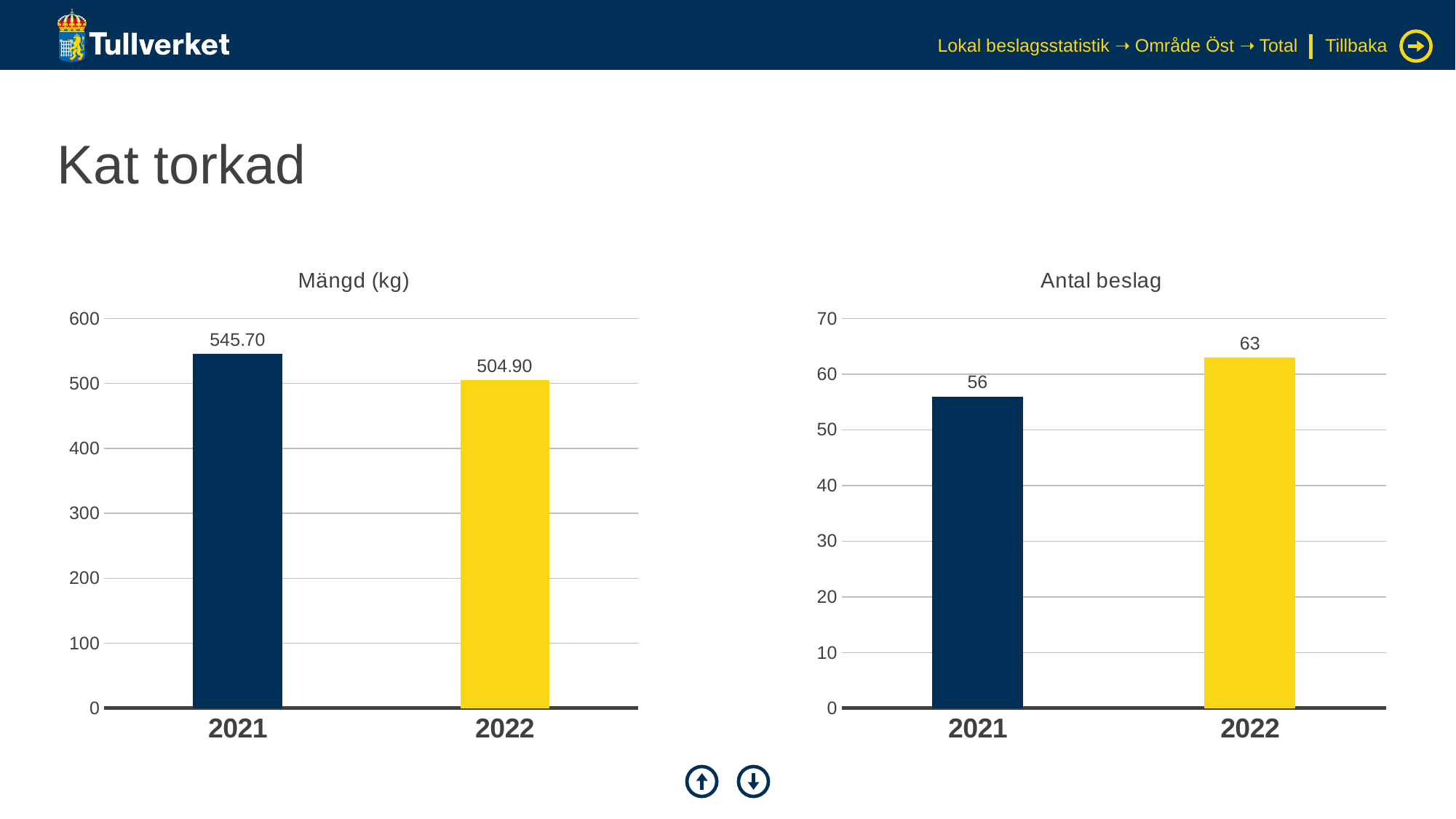
In the "Antal beslag" chart, what is the difference between the 2022 and 2021 values? 7 In the "Mängd (kg)" chart, what is the value for 2022? 504.90 In the "Mängd (kg)" chart, which year has the highest value? 2021 In the "Mängd (kg)" chart, how many years are shown on the x axis? 2 What kind of chart is the "Antal beslag" chart? bar chart In the "Antal beslag" chart, which year has the lowest value? 2021 In the "Antal beslag" chart, is the value for 2022 larger or smaller than the value for 2021? larger In the "Mängd (kg)" chart, do the values rise or fall from 2021 to 2022? fall In the "Mängd (kg)" chart, what is the difference between the 2021 and 2022 values? 40.80 In the "Antal beslag" chart, what is the value for 2022? 63 In the "Mängd (kg)" chart, what is the value for 2021? 545.70 In the "Antal beslag" chart, what is the value for 2021? 56